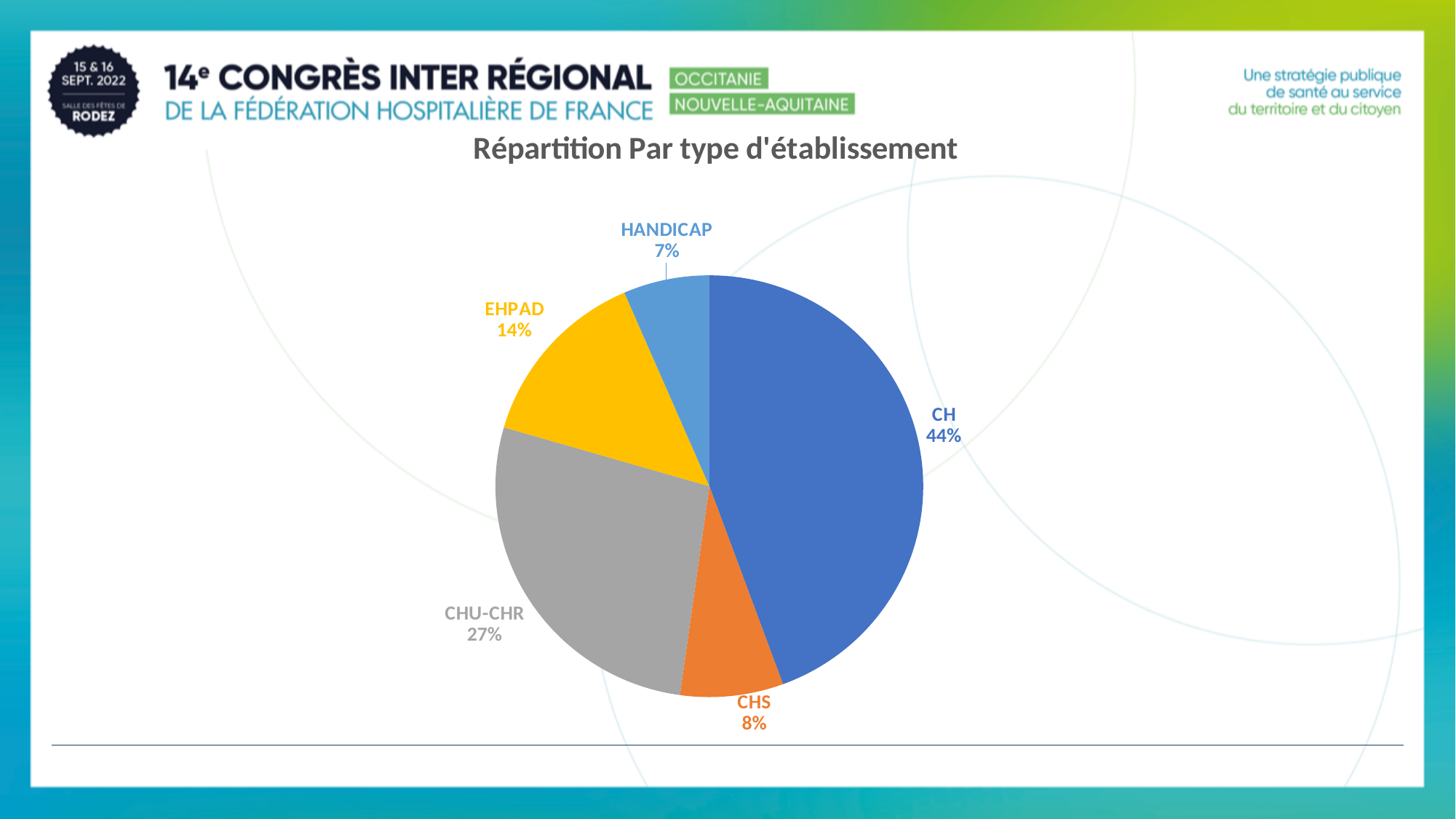
What is the value shown for EHPAD? 14% What is the value shown for CHU-CHR? 27% What type of chart is shown on the slide? pie chart What is the value shown for HANDICAP? 7% What is the value shown for CHS? 8% What share of the pie does CH represent? 44% What is the title of the chart? Répartition Par type d'établissement Which category has the smallest share of the pie? HANDICAP Which is larger, the share for EHPAD or the share for CHS? EHPAD What is the difference in percentage points between CH and CHU-CHR? 17 How many categories are shown in the pie chart? 5 Which category has the largest share of the pie? CH